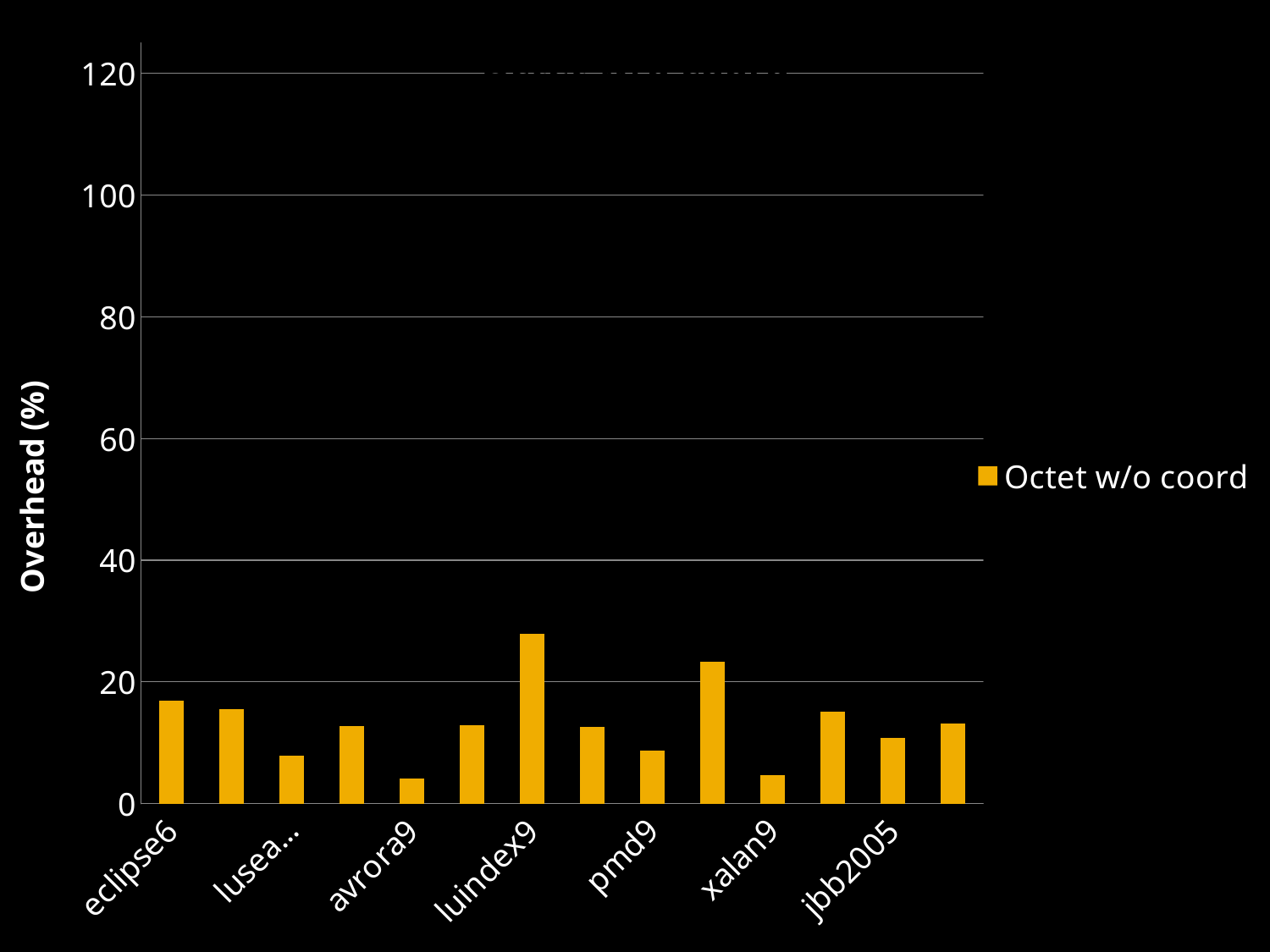
Is the value for luindex9 greater or less than 20? greater Which labeled benchmark has the highest overhead? luindex9 Is the value for eclipse6 greater or less than 20? less Which has the larger overhead, eclipse6 or jbb2005? eclipse6 What is the title of the vertical axis? Overhead (%) What kind of chart is shown on the slide? bar chart Which has the larger overhead, eclipse6 or avrora9? eclipse6 What is the name of the series shown in the legend? Octet w/o coord Is the value for avrora9 greater or less than 20? less How many series does the legend list? 1 Which has the larger overhead, luindex9 or pmd9? luindex9 How many bars are plotted in the chart? 14